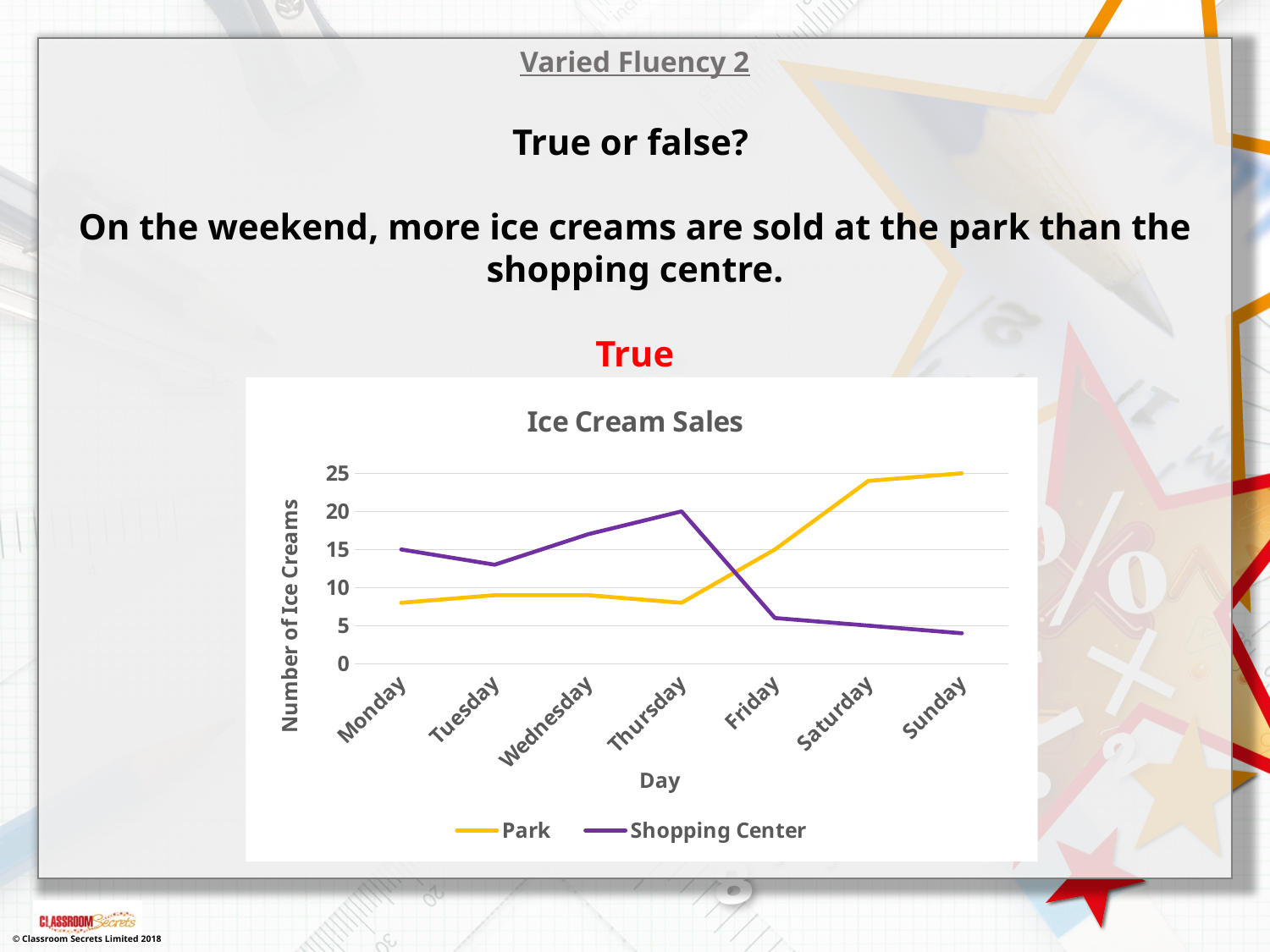
How many days are shown on the x axis? 7 What is the title of the chart? Ice Cream Sales How many ice creams were sold at the Shopping Center on Monday? 15 How many ice creams were sold at the Shopping Center on Thursday? 20 What type of chart is shown on the slide? Line chart On Thursday, which is larger: Park or Shopping Center? Shopping Center On which day is the Park value highest? Sunday How many ice creams were sold at the Park on Sunday? 25 Do the Shopping Center values rise or fall from Thursday to Sunday? Fall On which day is the Shopping Center value lowest? Sunday How many series does the legend list? 2 Is the value for the Park on Saturday greater or less than 20? greater